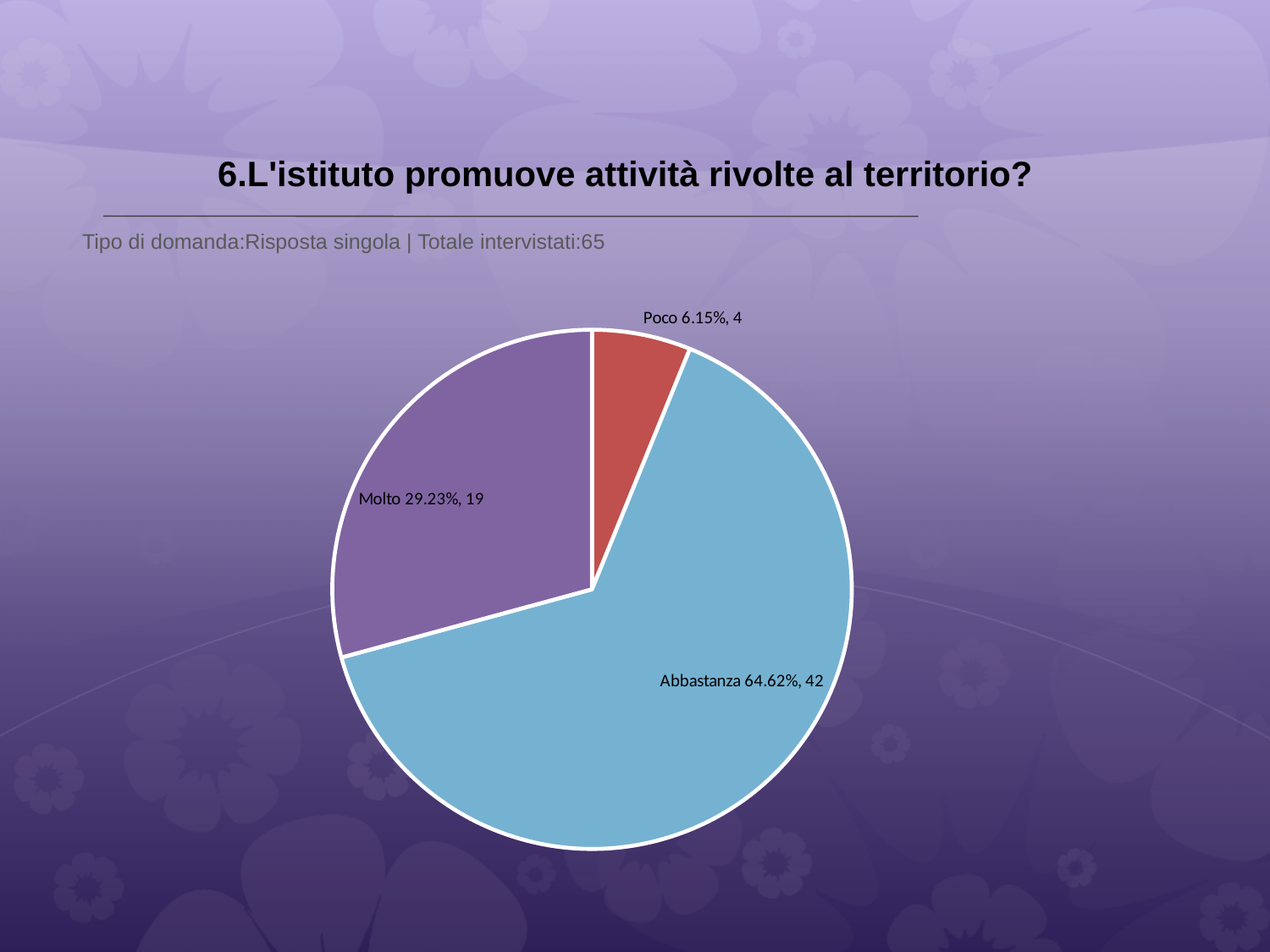
How many slices does the pie chart have? 3 Which has more respondents, Molto or Poco? Molto What is the total number of respondents across all slices? 65 How many respondents answered Molto? 19 What percentage share does the Poco slice have? 6.15% What colour is the Abbastanza slice? light blue What kind of chart is shown on the slide? pie chart How many respondents answered Poco? 4 Which response has the smallest slice of the pie? Poco Which response has the largest slice of the pie? Abbastanza What percentage share does the Abbastanza slice have? 64.62% What is the difference in respondent count between Abbastanza and Molto? 23